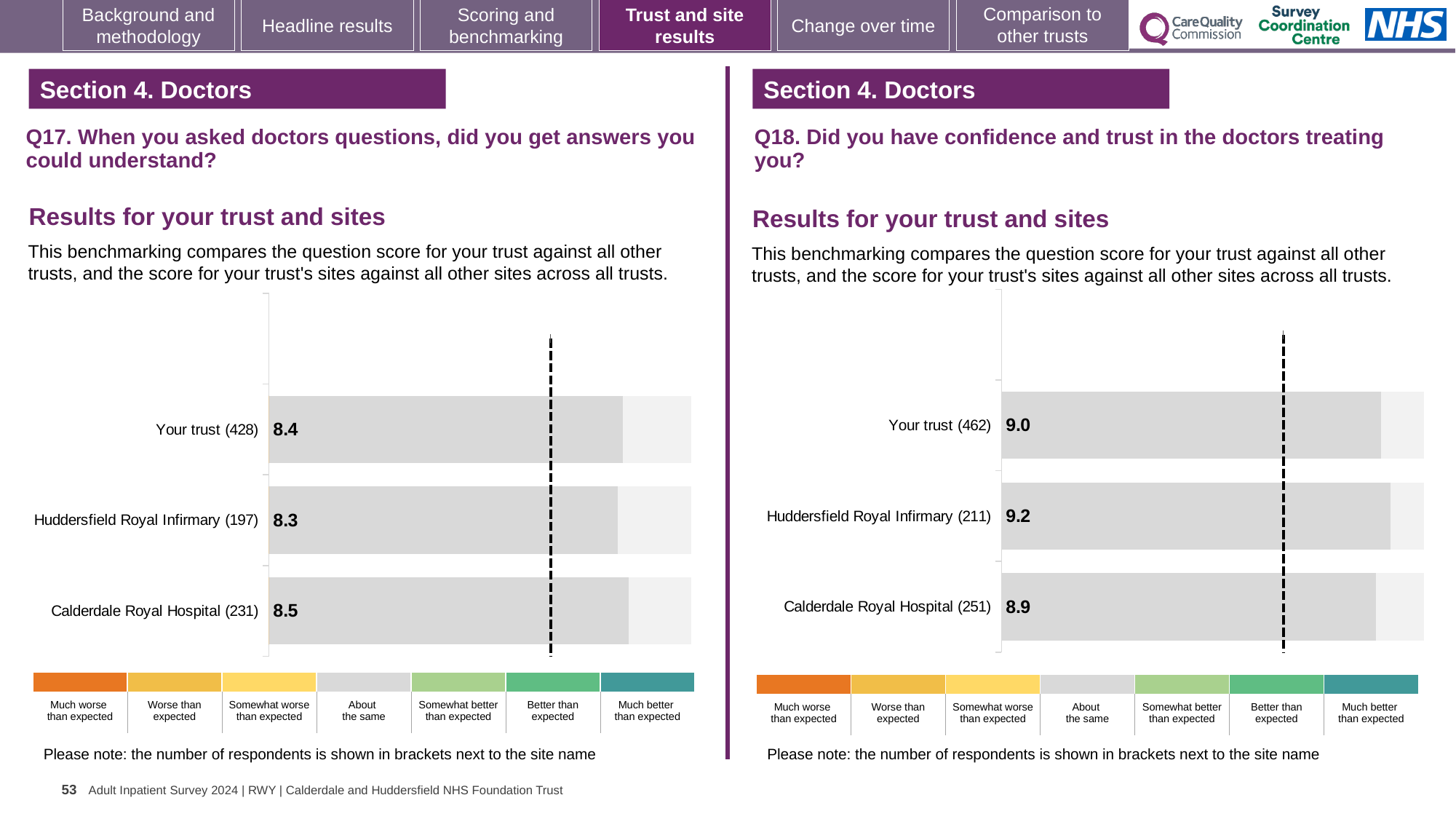
In the Q18 chart on the right, which is larger: the score for Your trust or the score for Calderdale Royal Hospital? Your trust In the Q17 chart on the left, how many respondents are shown for Huddersfield Royal Infirmary? 197 What type of chart is used in the Q18 chart on the right? Bar chart In the Q18 chart on the right, how many respondents are shown for Your trust? 462 How many bars are plotted in the Q17 chart on the left? 3 In the Q18 chart on the right, what is the difference between the scores for Huddersfield Royal Infirmary and Calderdale Royal Hospital? 0.3 In the Q18 chart on the right, which site or trust has the highest score? Huddersfield Royal Infirmary In the Q17 chart on the left, which site or trust has the lowest score? Huddersfield Royal Infirmary In the Q17 chart on the left, what is the score for Your trust? 8.4 In the Q17 chart on the left, what is the score for Calderdale Royal Hospital? 8.5 In the Q18 chart on the right, what is the score for Huddersfield Royal Infirmary? 9.2 In the Q17 chart on the left, what is the difference between the scores for Calderdale Royal Hospital and Huddersfield Royal Infirmary? 0.2